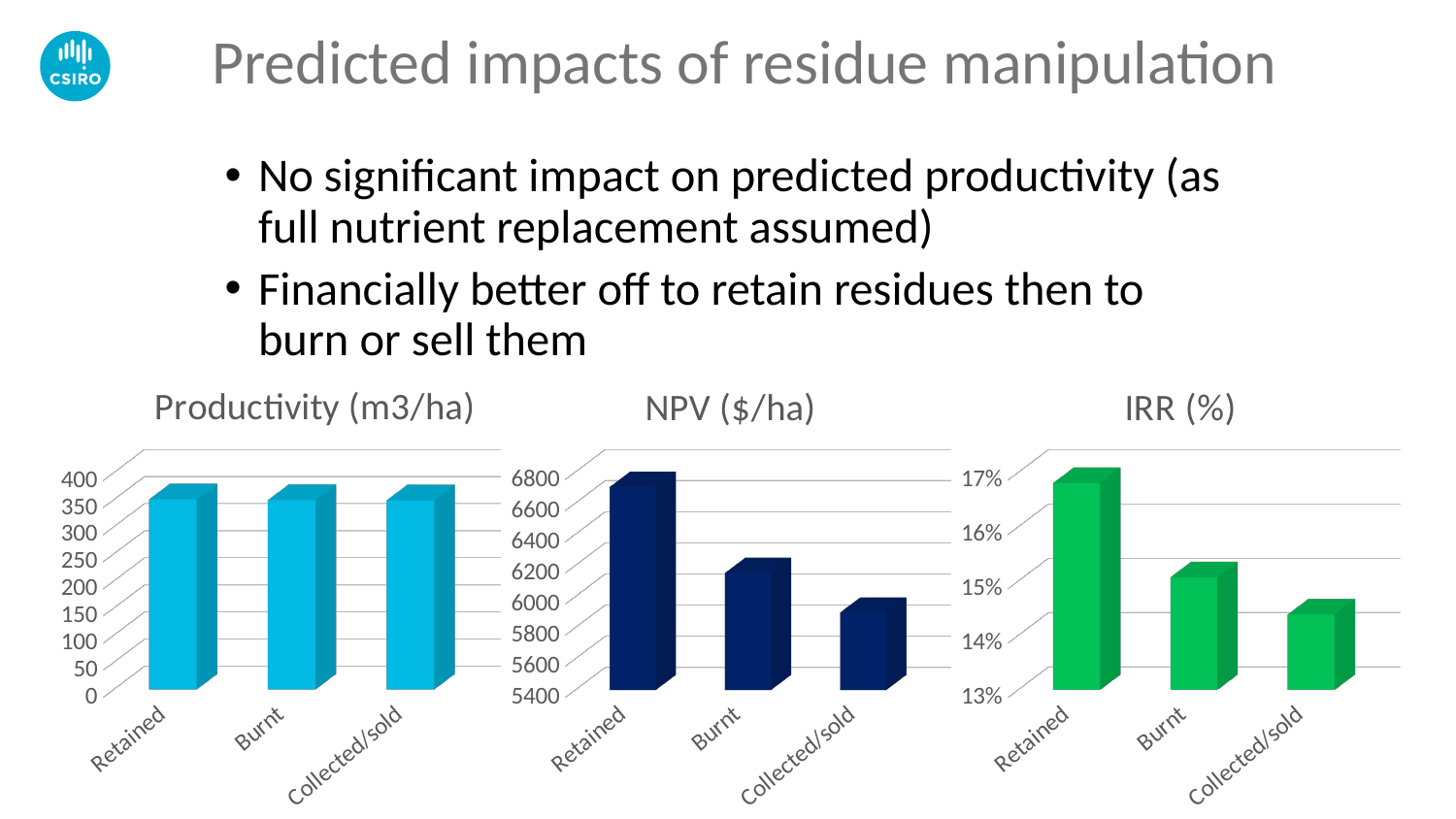
In the IRR (%) chart, is the value for Retained greater or less than 16%? greater In the NPV ($/ha) chart, is the value for Collected/sold greater or less than 6200? less What kind of chart is the NPV ($/ha) chart? bar chart In the NPV ($/ha) chart, which is larger, Burnt or Collected/sold? Burnt How many categories are shown on the Productivity (m3/ha) chart? 3 In the IRR (%) chart, which category has the lowest value? Collected/sold In the NPV ($/ha) chart, which category has the highest value? Retained In the NPV ($/ha) chart, which category has the lowest value? Collected/sold In the NPV ($/ha) chart, is the value for Retained greater or less than 6400? greater In the IRR (%) chart, which category has the highest value? Retained In the IRR (%) chart, do the values rise or fall from Retained to Collected/sold? fall